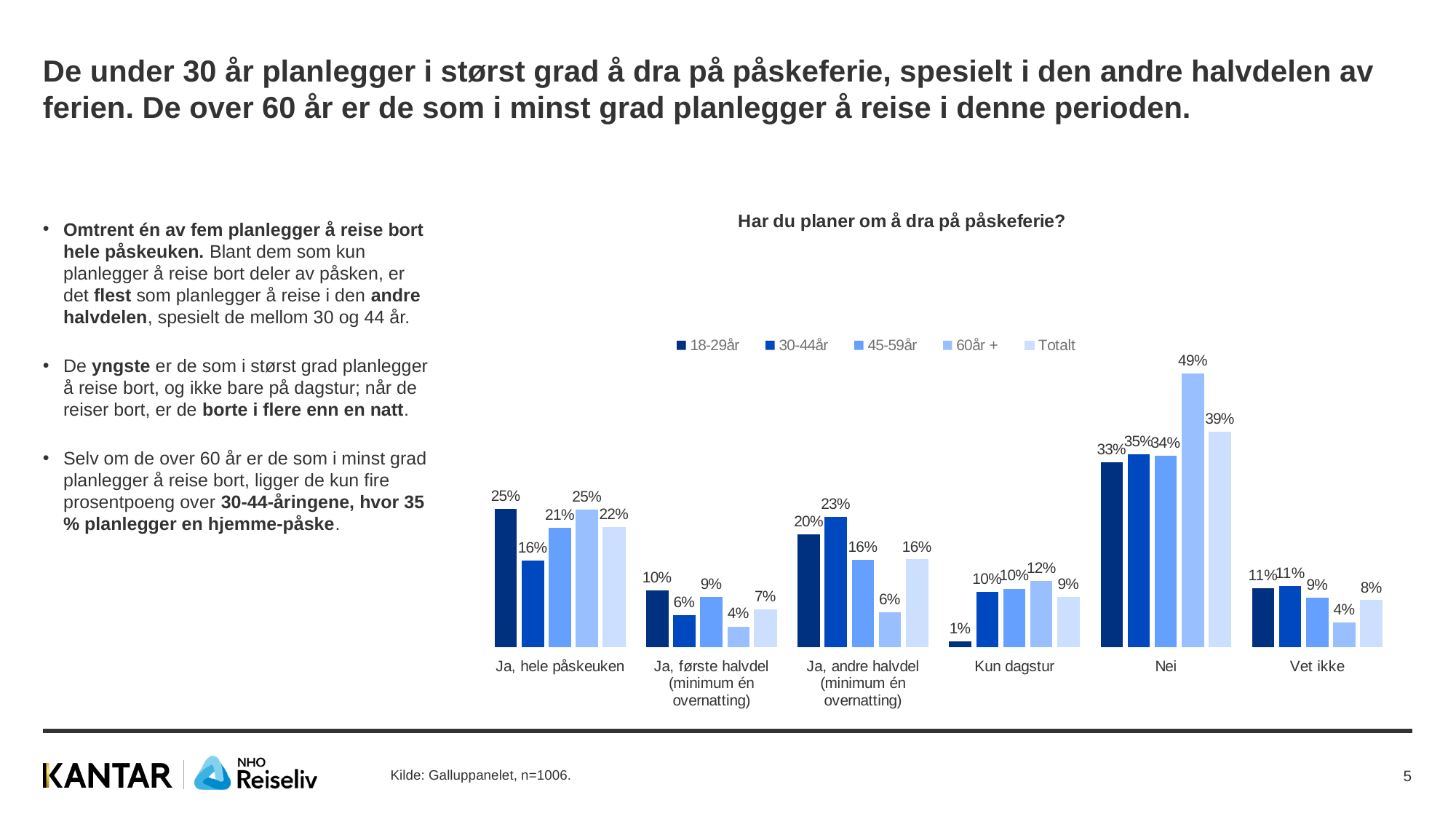
What is the title of the chart? Har du planer om å dra på påskeferie? What kind of chart is shown on the slide? Bar chart What is the value for 60år + in the 'Nei' category? 49% What is the value for 30-44år in the 'Ja, andre halvdel (minimum én overnatting)' category? 23% Which is larger in the 'Ja, første halvdel (minimum én overnatting)' category: the value for 18-29år or the value for 60år +? 18-29år How many series does the legend list? 5 What is the Totalt value for 'Ja, hele påskeuken'? 22% Which age group has the highest value in the 'Nei' category? 60år + What is the difference between the 60år + value and the 30-44år value in the 'Nei' category? 14% Which age group has the lowest value in the 'Ja, hele påskeuken' category? 30-44år What is the value for 18-29år in the 'Kun dagstur' category? 1% How many categories are shown on the x axis? 6